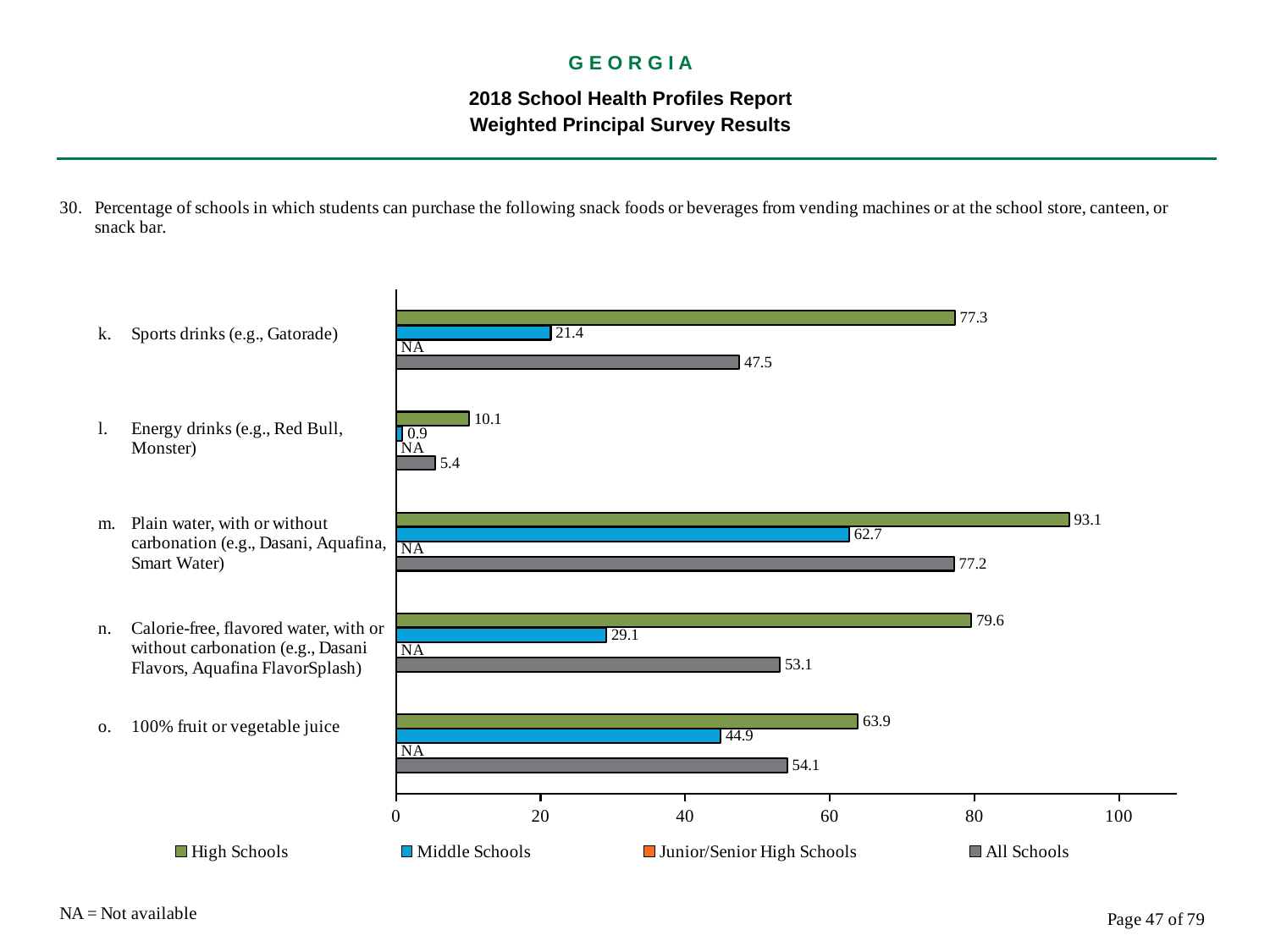
How many categories are shown on the chart? 5 Which category has the lowest All Schools value? Energy drinks (e.g., Red Bull, Monster) What is the Middle Schools value for Plain water, with or without carbonation? 62.7 Which is larger for 100% fruit or vegetable juice: the Middle Schools value or the All Schools value? All Schools Which category has the highest High Schools value? Plain water, with or without carbonation How many series does the legend list? 4 What is the All Schools value for 100% fruit or vegetable juice? 54.1 What is the difference between the High Schools and Middle Schools values for Calorie-free, flavored water? 50.5 What is the High Schools value for Sports drinks (e.g., Gatorade)? 77.3 What is the Middle Schools value for Energy drinks (e.g., Red Bull, Monster)? 0.9 What kind of chart is shown? Bar chart What value is shown for Junior/Senior High Schools for Sports drinks? NA